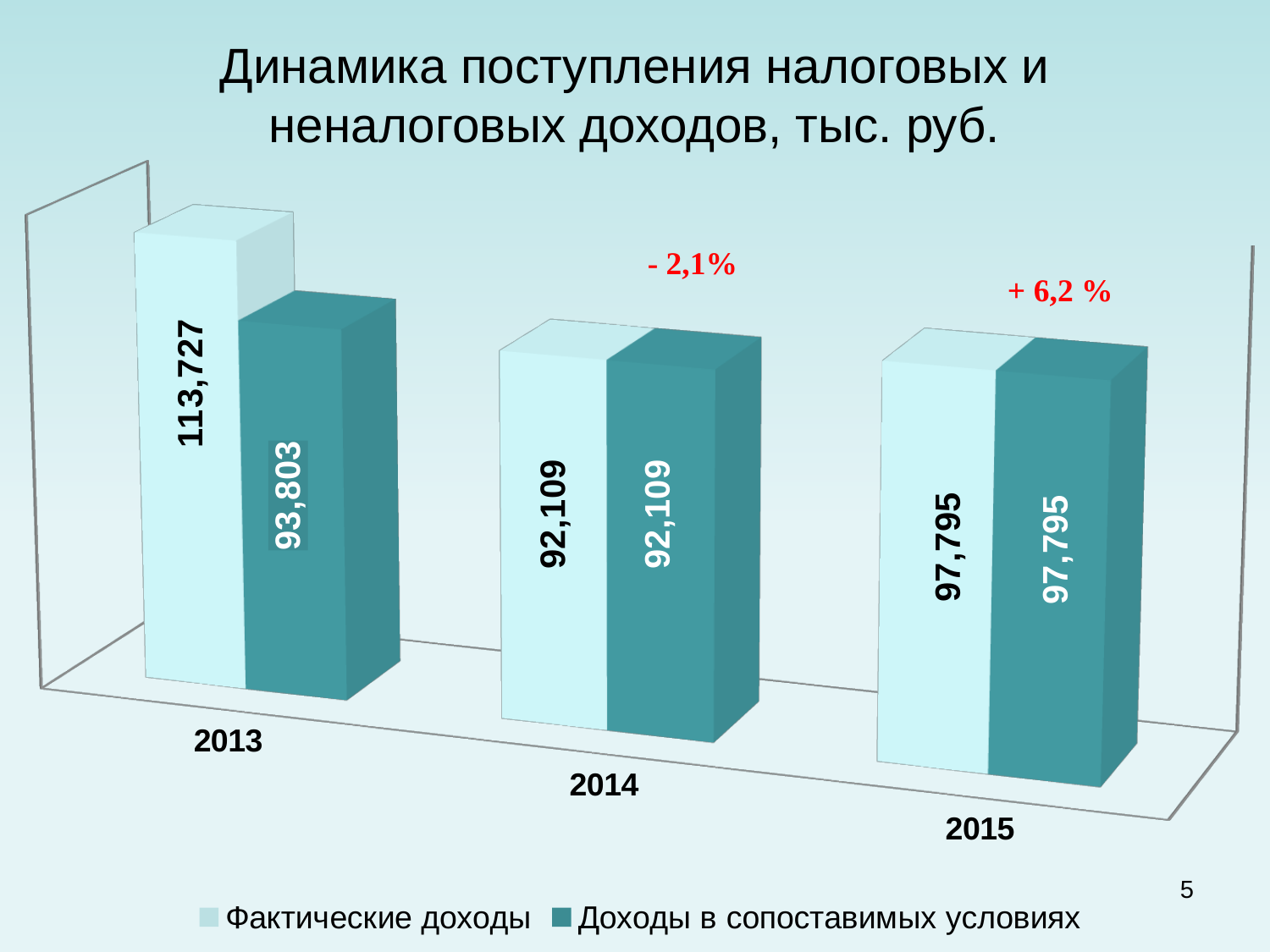
Which year has the highest value for Фактические доходы? 2013 What is the value of Фактические доходы for 2013? 113,727 What percentage change is annotated above the 2015 bars? + 6,2 % Which is larger: Доходы в сопоставимых условиях in 2015 or in 2014? 2015 What is the value of Доходы в сопоставимых условиях for 2013? 93,803 What is the value of Фактические доходы for 2014? 92,109 What is the difference between Фактические доходы and Доходы в сопоставимых условиях in 2013? 19,924 How many series does the legend list? 2 Which year has the lowest value for Доходы в сопоставимых условиях? 2014 How many years are shown on the x axis? 3 What kind of chart is shown on the slide? Bar chart What is the value of Доходы в сопоставимых условиях for 2015? 97,795